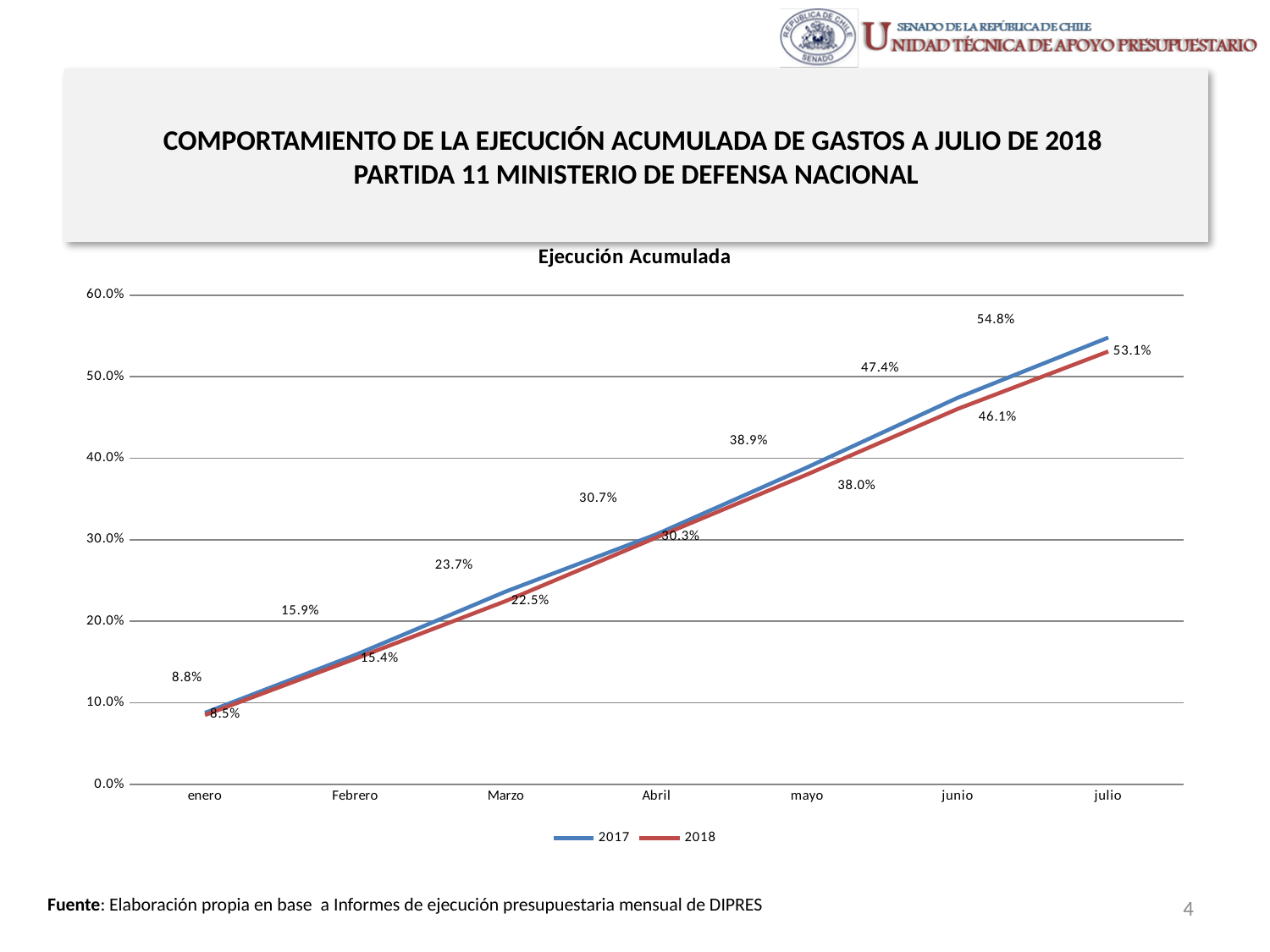
Do the values for 2017 rise or fall from enero to julio? rise What is the title of the chart? Ejecución Acumulada What is the value for 2017 in mayo? 38.9% What is the value for 2018 in enero? 8.5% How many months are shown on the x axis? 7 What is the difference between the 2017 and 2018 values in julio? 1.7% How many series does the legend list? 2 What is the value for 2017 in julio? 54.8% What is the value for 2018 in julio? 53.1% Which series has the higher value in junio, 2017 or 2018? 2017 In which month is the 2018 series lowest? enero What type of chart is shown on the slide? line chart